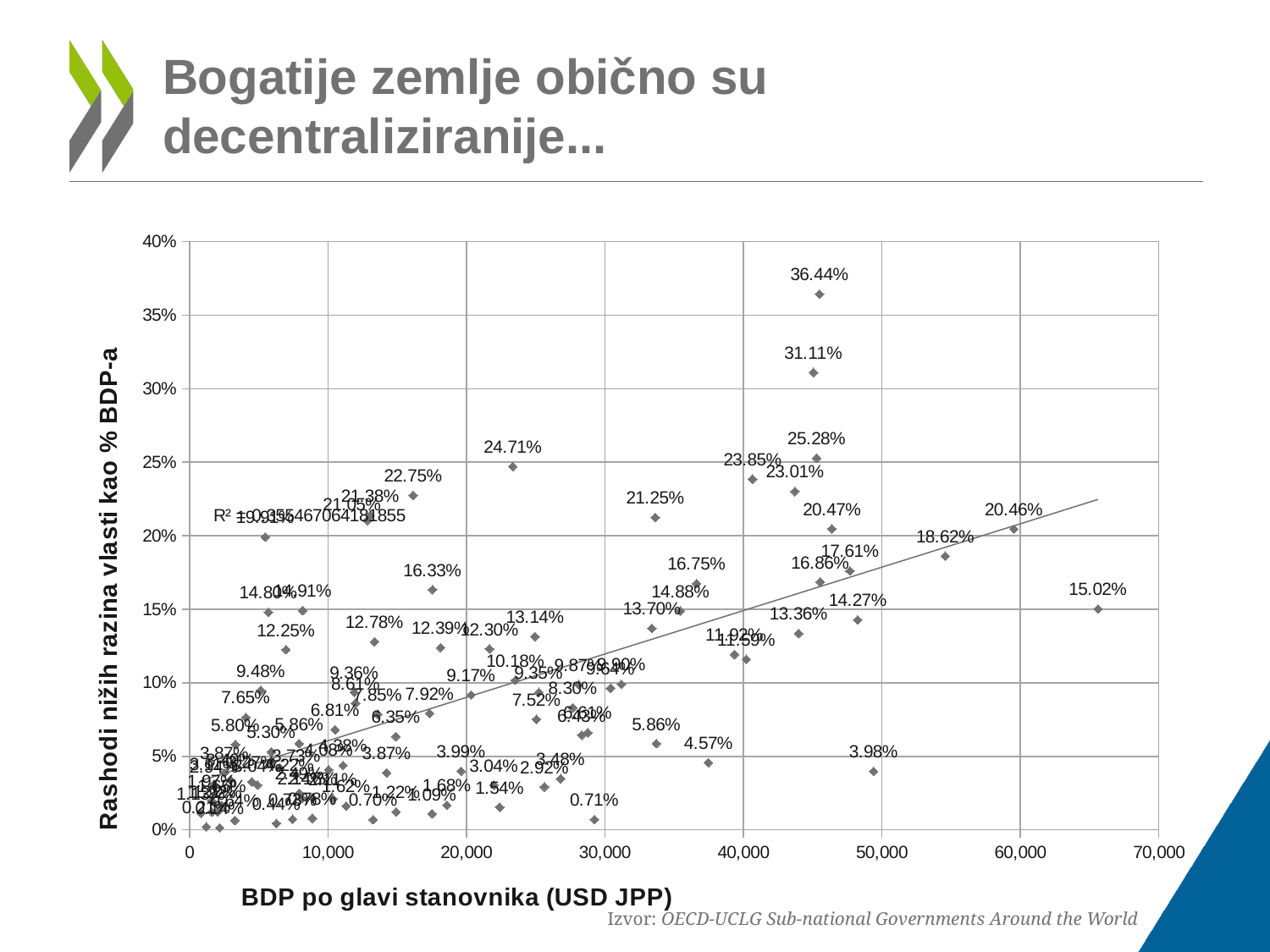
What is the difference between the two highest labelled values, 36.44% and 31.11%? 5.33 percentage points What is the maximum value shown on the y axis? 40% What is the value labelled on the rightmost point of the chart (near 65,000 on the x axis)? 15.02% Which is larger, the point labelled 24.71% or the point labelled 22.75%? 24.71% Is the highest point on the chart greater or less than 35%? greater What is the label of the x axis? BDP po glavi stanovnika (USD JPP) What is the highest value labelled on the chart? 36.44% Does the trend line on the chart rise or fall as GDP per capita increases along the x axis? Rises What kind of chart is shown on the slide? Scatter chart What is the second-highest value labelled on the chart? 31.11%